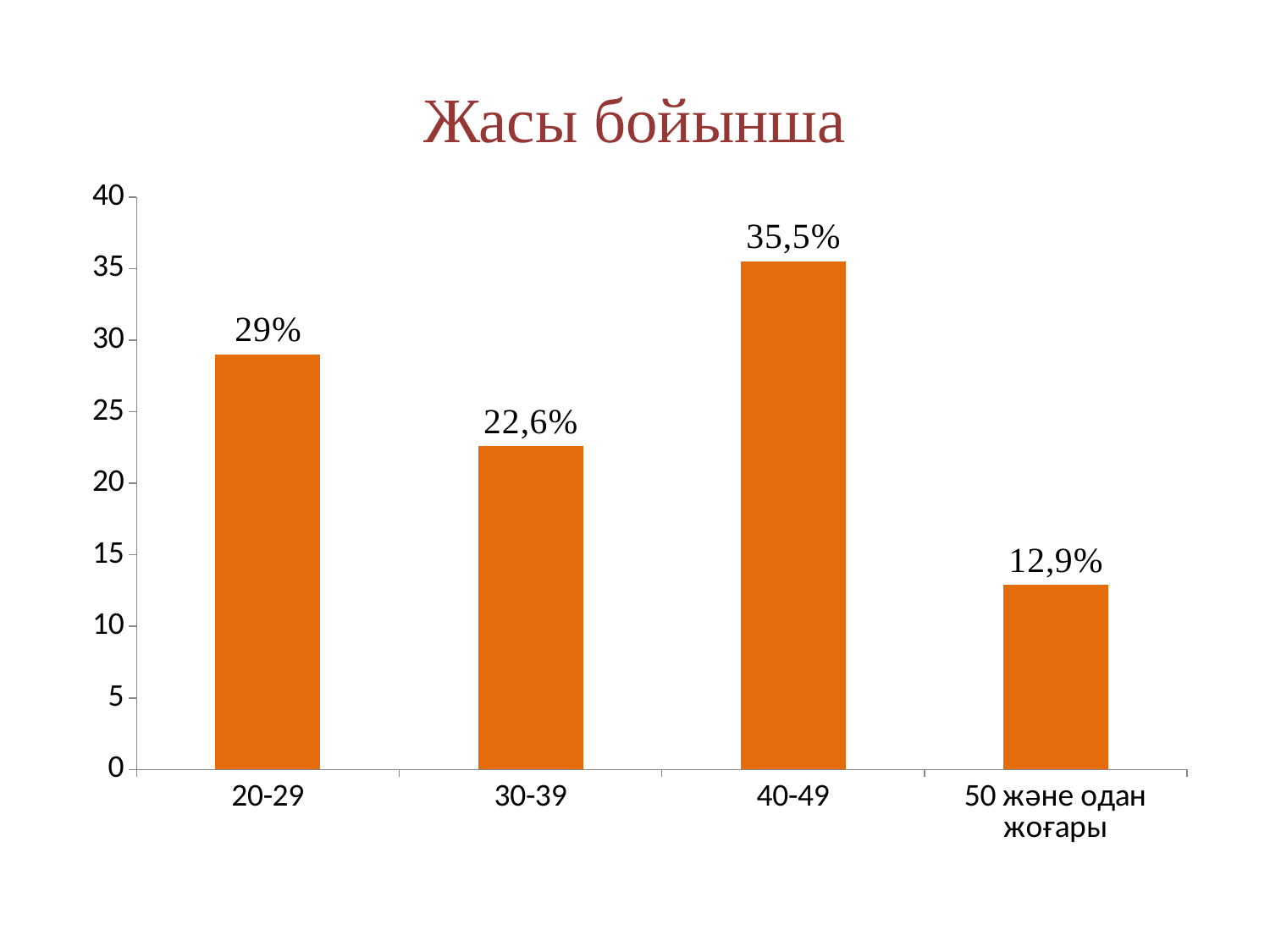
Which is larger, the value for 20-29 or the value for 30-39? 20-29 Which age group has the highest value? 40-49 What is the value for the 20-29 age group? 29% What is the title of the chart? Жасы бойынша How many age categories are shown on the chart? 4 What is the value for the 40-49 age group? 35,5% Which age group has the lowest value? 50 және одан жоғары What is the difference between the values for 30-39 and 50 және одан жоғары? 9,7% What is the value for the 30-39 age group? 22,6% What is the value for the '50 және одан жоғары' category? 12,9% What kind of chart is shown on the slide? Bar chart What is the difference between the values for 40-49 and 20-29? 6,5%